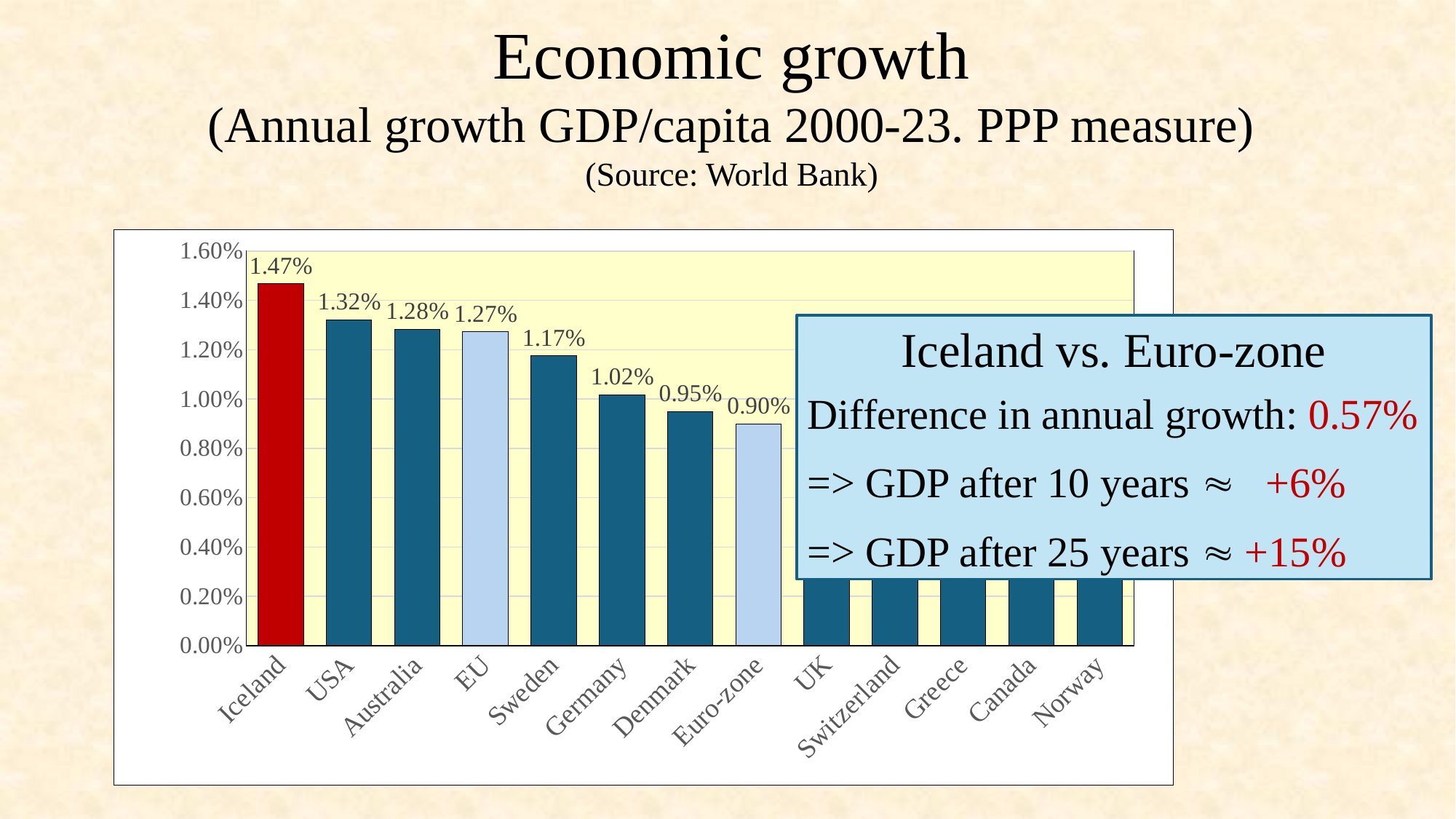
What is the value shown for Sweden? 1.17% Do the labelled bar values rise or fall from left to right across the chart? fall Which country has the highest annual growth in the chart? Iceland How many countries or regions are shown on the x axis of the chart? 13 Which has a larger value, Sweden or Germany? Sweden What is the value shown for the Euro-zone bar? 0.90% What is the annual GDP/capita growth value shown for Iceland? 1.47% What is the difference between the values for USA and Australia? 0.04% What is the value shown for Germany? 1.02% What is the difference between the values for Iceland and the Euro-zone? 0.57% Is the value for Denmark greater or less than 1.00%? less What kind of chart is shown on the slide? bar chart